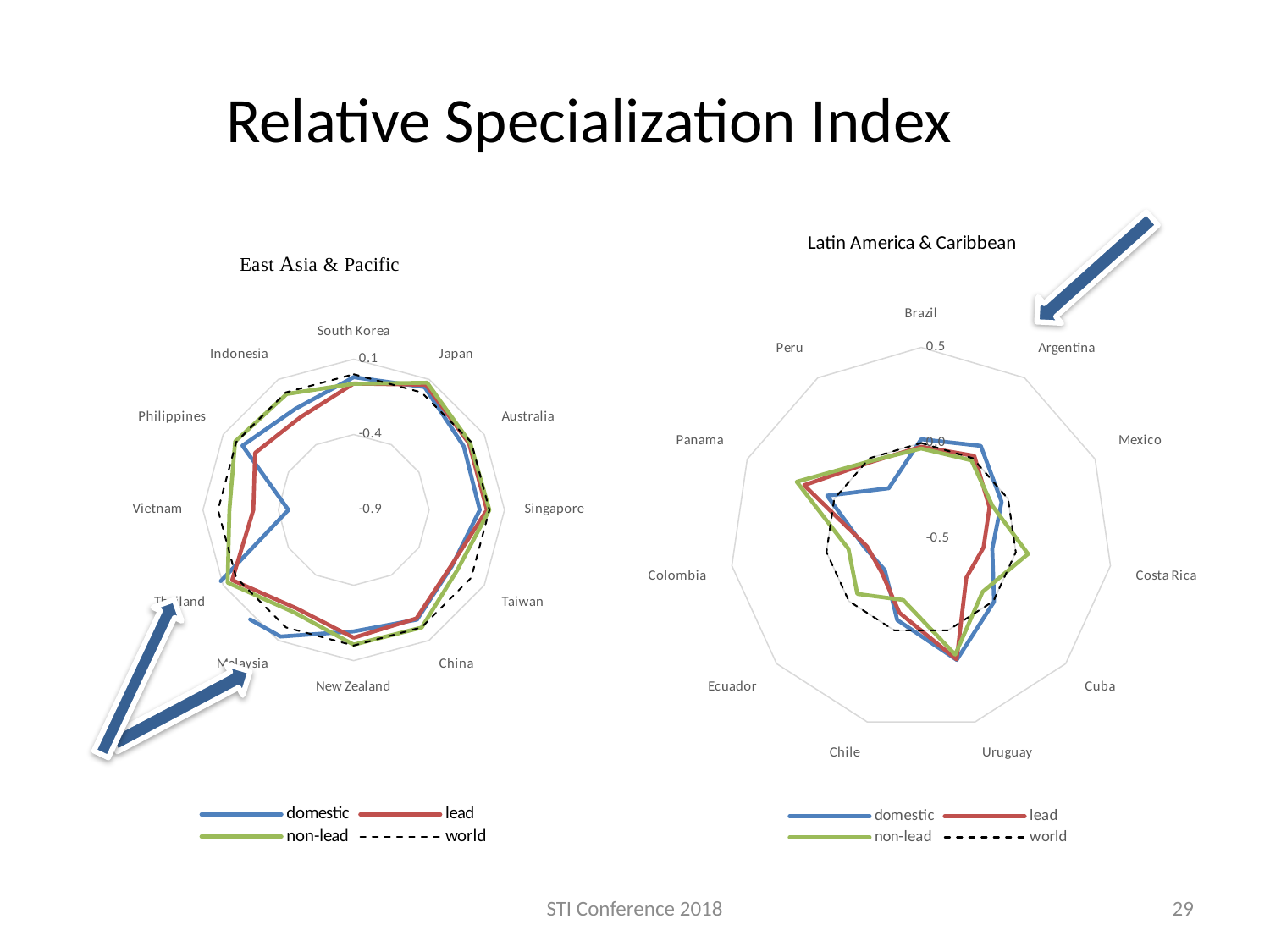
What kind of chart is the East Asia & Pacific chart? radar chart How many countries are plotted on the East Asia & Pacific chart? 12 What kind of chart is the Latin America & Caribbean chart? radar chart In the East Asia & Pacific chart, is the domestic value for Singapore greater or less than -0.4? greater In the Latin America & Caribbean chart, is the non-lead value for Panama greater or less than 0.0? greater In the East Asia & Pacific chart, is the domestic value for the Philippines greater or less than -0.4? greater How many series does the legend of the Latin America & Caribbean chart list? 4 How many countries are plotted on the Latin America & Caribbean chart? 11 Which series is drawn with a dashed line in the legends of both charts? world What is the title of the chart on the left side of the slide? East Asia & Pacific How many series does the legend of the East Asia & Pacific chart list? 4